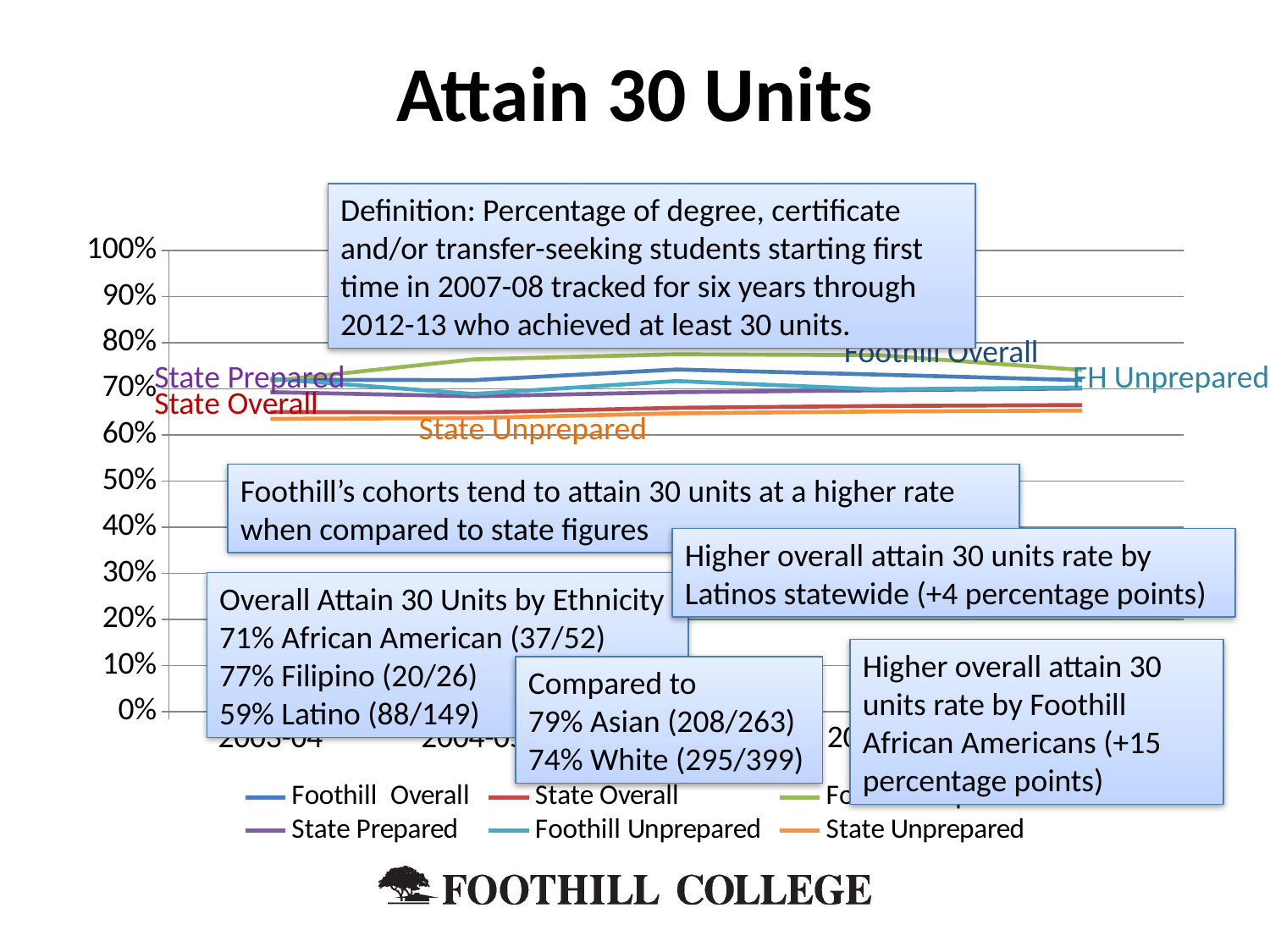
What kind of chart is shown on the slide? line chart Which series has the lowest values on the chart? State Unprepared Is the value for State Unprepared greater or less than 70%? less What is the title of the chart? Attain 30 Units Is the value for Foothill Unprepared greater or less than 60%? greater Which series is higher, Foothill Unprepared or State Unprepared? Foothill Unprepared Is the value for Foothill Overall greater or less than 60%? greater Which series is higher, Foothill Overall or State Overall? Foothill Overall What is the highest value shown on the y axis? 100% How many series does the chart legend list? 6